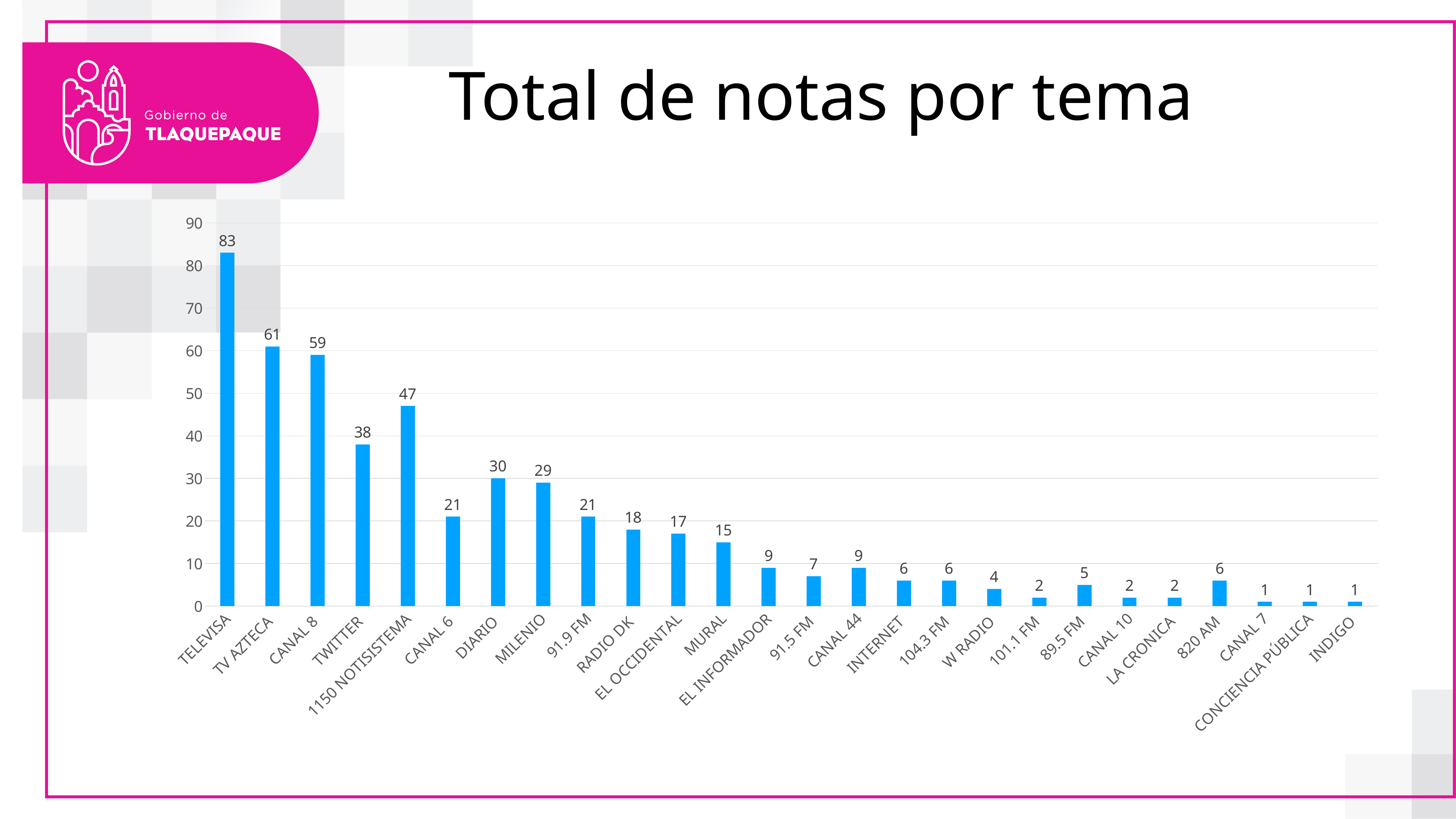
What is the title of the slide? Total de notas por tema What is the difference between the values for TV AZTECA and CANAL 8? 2 What is the value for 1150 NOTISISTEMA? 47 Which is larger, the value for RADIO DK or the value for EL OCCIDENTAL? RADIO DK Which is larger, the value for DIARIO or the value for MILENIO? DIARIO What is the value for TELEVISA? 83 What kind of chart is shown on the slide? Bar chart Which category has the highest value? TELEVISA How many categories are shown on the x axis? 26 What is the value for 820 AM? 6 What is the value for MURAL? 15 What is the difference between the values for TELEVISA and TWITTER? 45